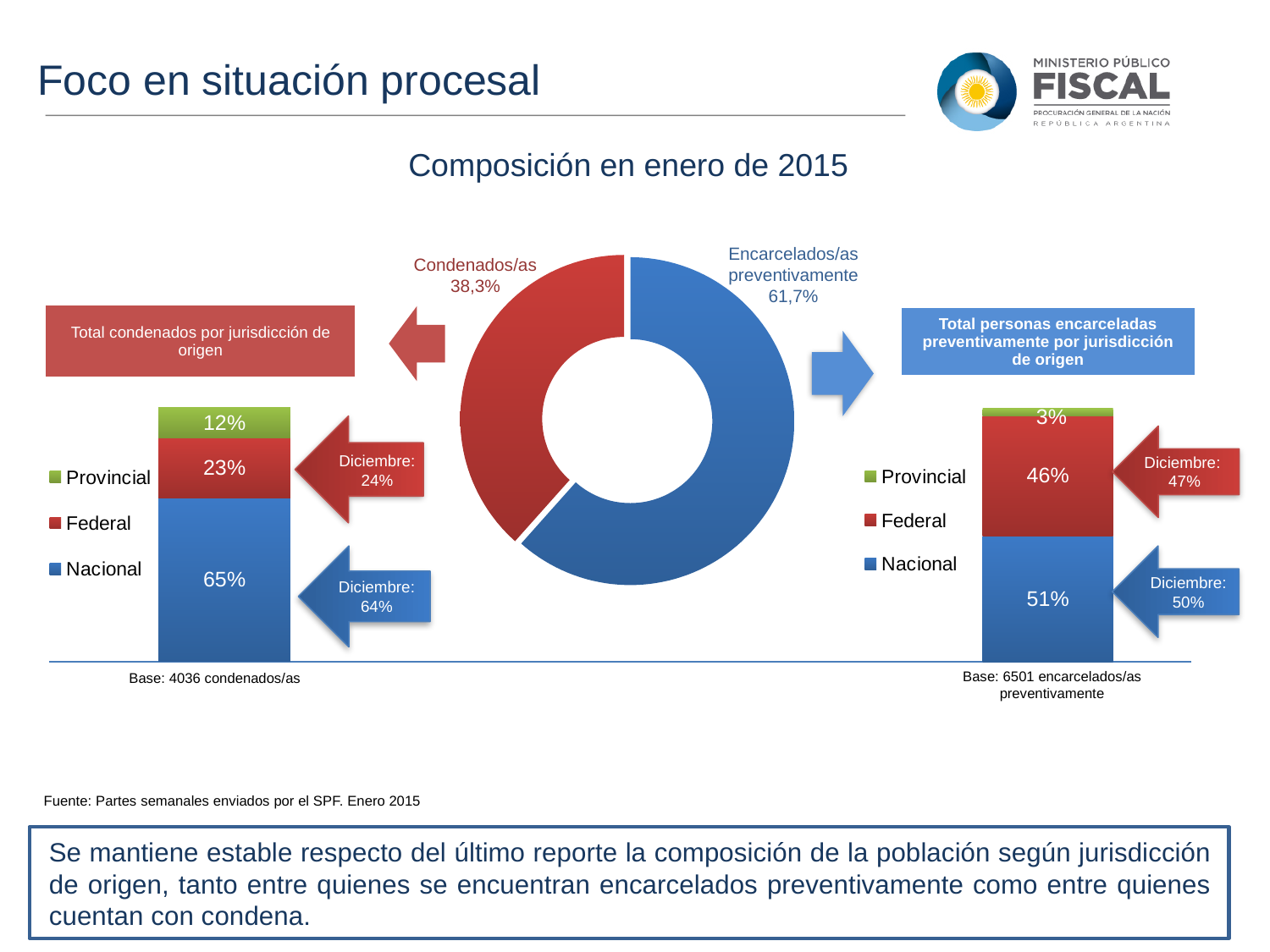
In the central donut chart, what share is labelled Encarcelados/as preventivamente? 61,7% In the left stacked bar chart (Total condenados por jurisdicción de origen), which jurisdiction has the smallest share? Provincial In the central donut chart, which segment is larger, Condenados/as or Encarcelados/as preventivamente? Encarcelados/as preventivamente In the right stacked bar chart (Total personas encarceladas preventivamente por jurisdicción de origen), what is the value for Provincial? 3% What kind of chart is the central chart showing Condenados/as and Encarcelados/as preventivamente? Donut (pie) chart In the central donut chart, what share is labelled Condenados/as? 38,3% How many series does the legend of the left stacked bar chart list? 3 In the left stacked bar chart (Total condenados por jurisdicción de origen), what is the value for Nacional? 65% In the right stacked bar chart (Total personas encarceladas preventivamente por jurisdicción de origen), which jurisdiction has the largest share? Nacional In the right stacked bar chart (Total personas encarceladas preventivamente por jurisdicción de origen), what is the value for Federal? 46% In the left stacked bar chart (Total condenados por jurisdicción de origen), what is the value for Federal? 23% In the left stacked bar chart (Total condenados por jurisdicción de origen), what is the difference between the Nacional and Federal values? 42%